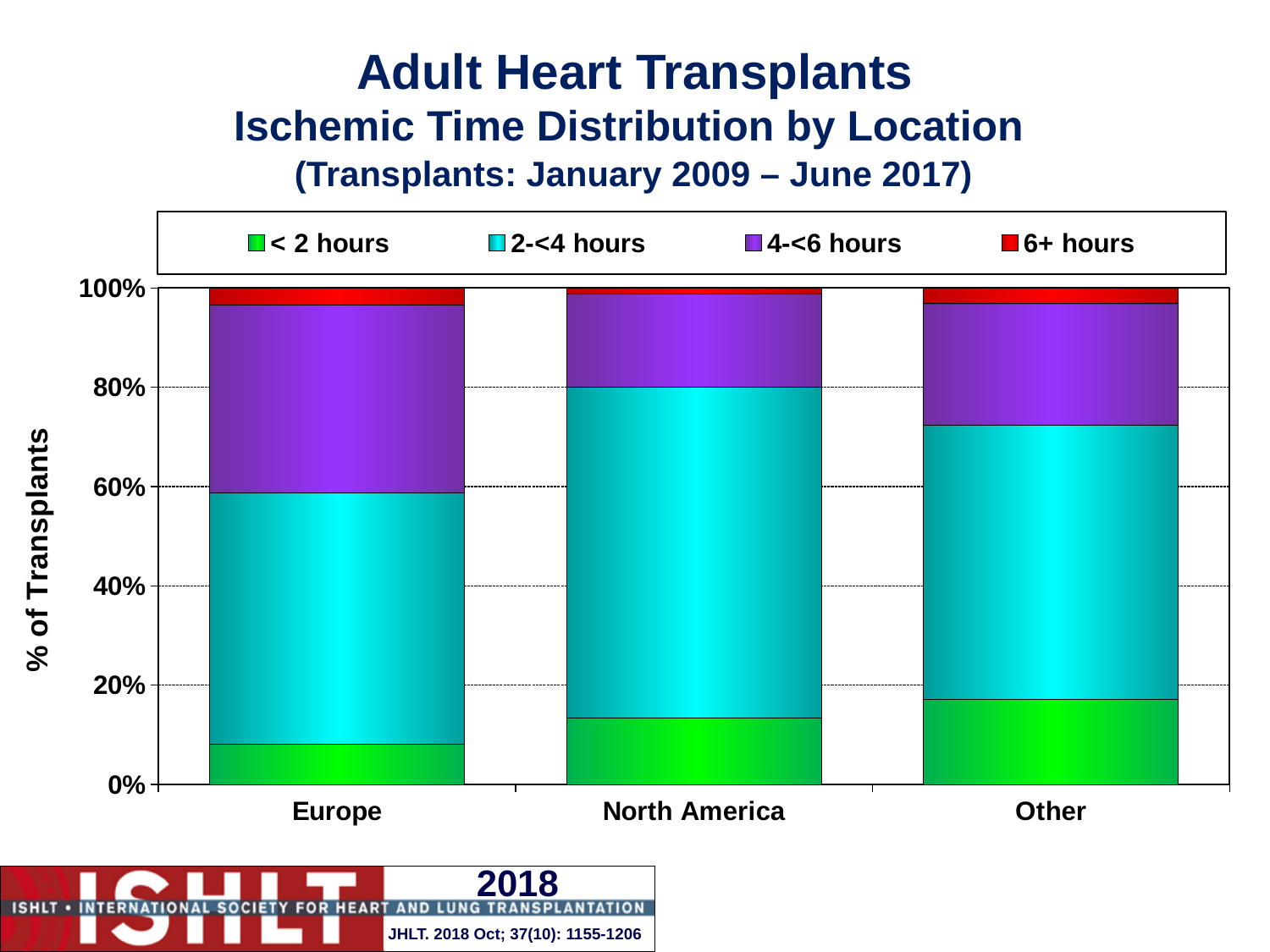
How many series does the legend list? 4 How many locations are shown on the x axis? 3 Which location has the largest share of transplants with an ischemic time of 2-<4 hours? North America Is the share of transplants with an ischemic time of 4-<6 hours in Europe greater or less than 20%? greater Is the share of transplants with an ischemic time of < 2 hours in Europe greater or less than 20%? less Which location has the smallest share of transplants with an ischemic time of < 2 hours? Europe What kind of chart is shown on the slide? stacked bar chart Which location has the largest share of transplants with an ischemic time of 4-<6 hours? Europe Which is larger: the share of < 2 hours transplants in Other or in North America? Other Is the share of transplants with an ischemic time of 2-<4 hours in North America greater or less than 60%? greater What does each stacked bar total? 100% What is the label of the y axis? % of Transplants